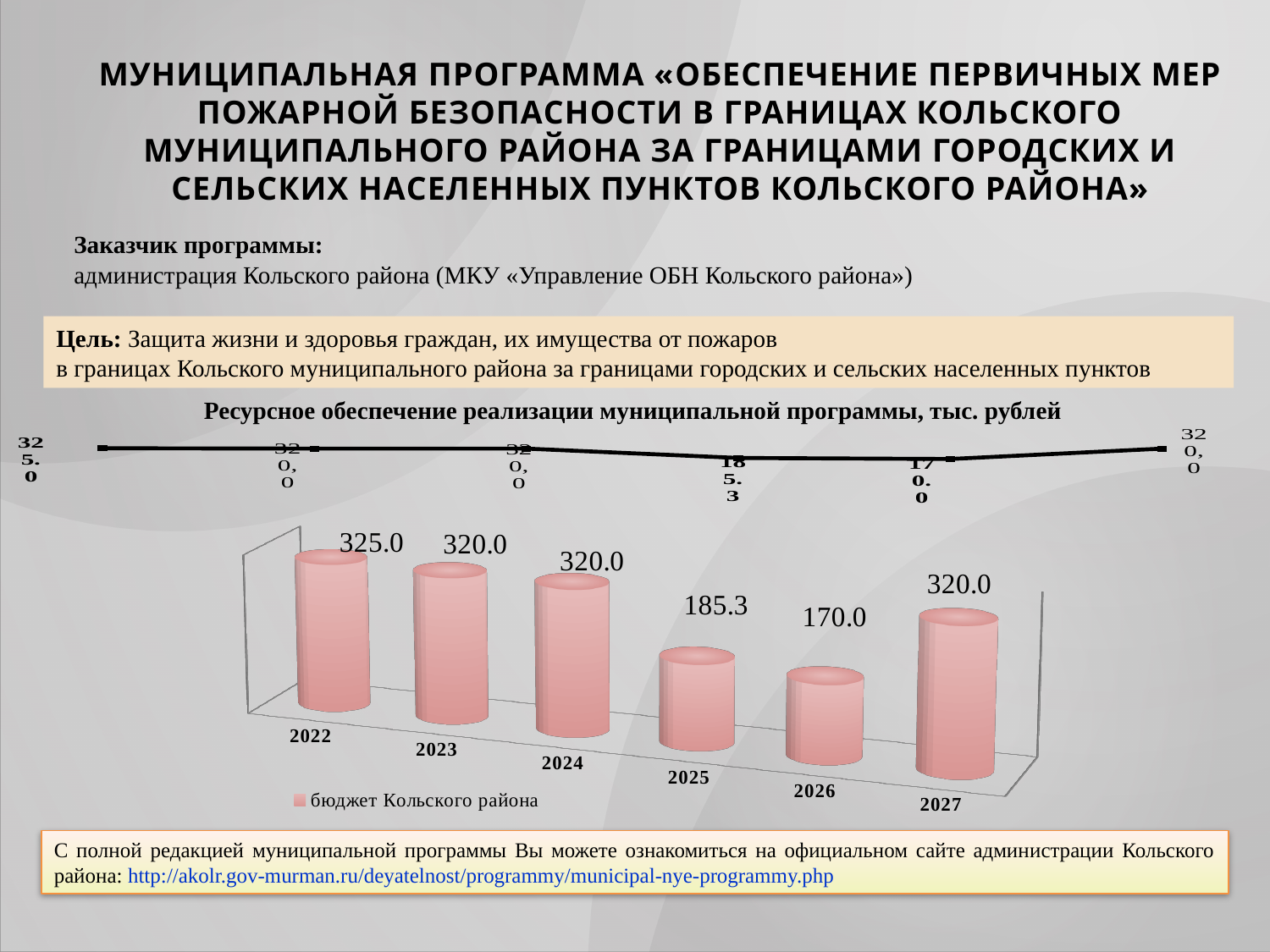
What is the value for 2022 in the chart 'Ресурсное обеспечение реализации муниципальной программы, тыс. рублей'? 325.0 Which year has the highest value in the chart? 2022 What kind of chart is used to show the resource provision by year? Bar chart How many series does the chart legend list? 1 How many years are shown in the chart? 6 What is the difference between the values for 2022 and 2026? 155.0 Which year has the lowest value in the chart? 2026 Which is larger, the value for 2025 or the value for 2026? 2025 What is the value for 2025 in the chart? 185.3 What is the value for 2026 in the chart? 170.0 What is the difference between the values for 2024 and 2025? 134.7 What is the legend entry of the chart? бюджет Кольского района